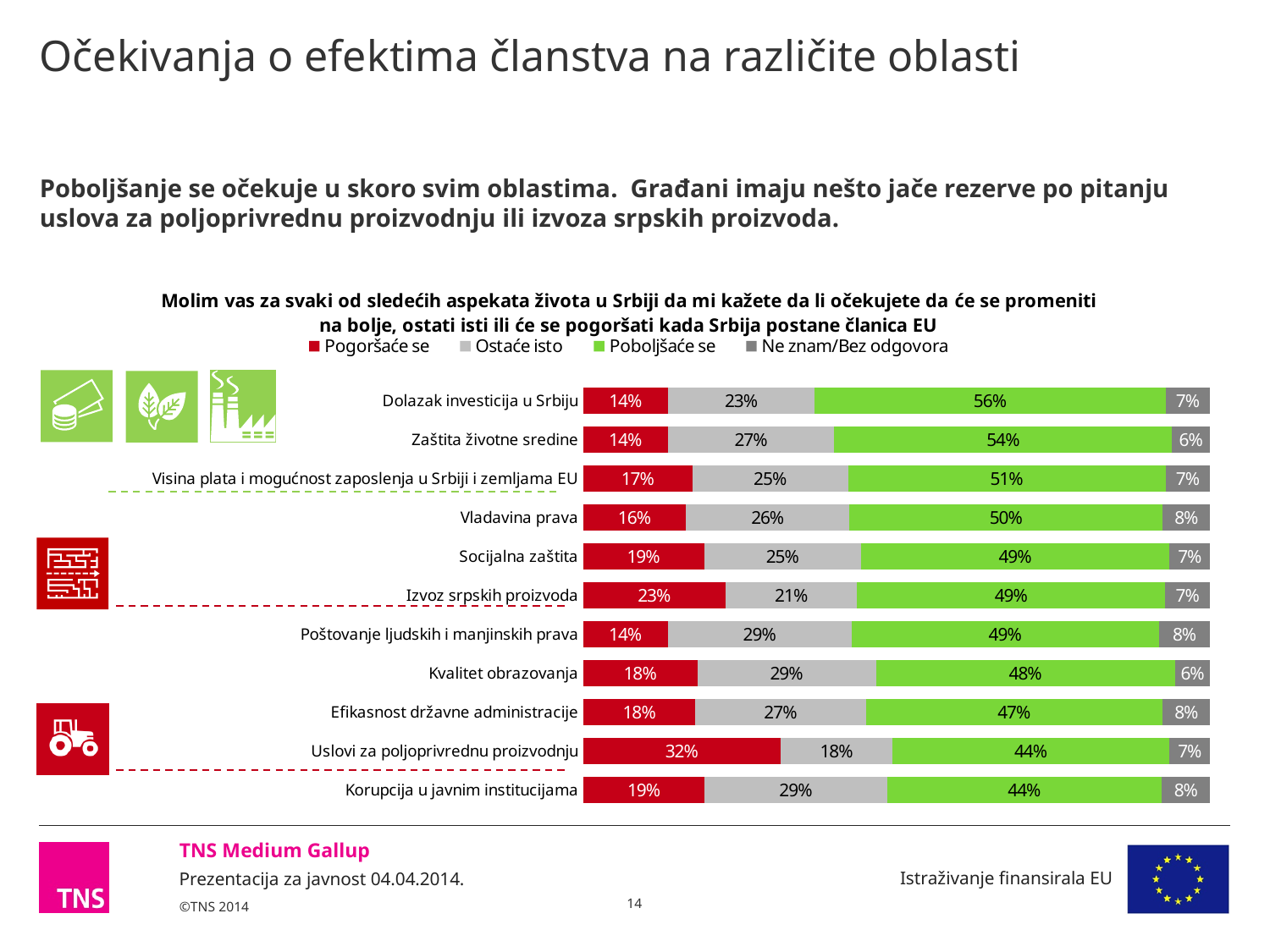
What is the 'Ostaće isto' value for 'Izvoz srpskih proizvoda'? 21% What is the difference between the 'Poboljšaće se' values for 'Dolazak investicija u Srbiju' and 'Korupcija u javnim institucijama'? 12% What kind of chart is shown on the slide? Stacked bar chart What is the total of the stacked bar for 'Vladavina prava'? 100% Which category has the highest 'Poboljšaće se' value? Dolazak investicija u Srbiju Which is larger: the 'Pogoršaće se' value for 'Izvoz srpskih proizvoda' or for 'Socijalna zaštita'? Izvoz srpskih proizvoda How many series does the legend list? 4 How many categories (aspects of life) are plotted in the chart? 11 Which legend entry is shown in green? Poboljšaće se Which category has the highest 'Pogoršaće se' value? Uslovi za poljoprivrednu proizvodnju What is the 'Pogoršaće se' value for 'Uslovi za poljoprivrednu proizvodnju'? 32% What is the 'Poboljšaće se' value for 'Dolazak investicija u Srbiju'? 56%